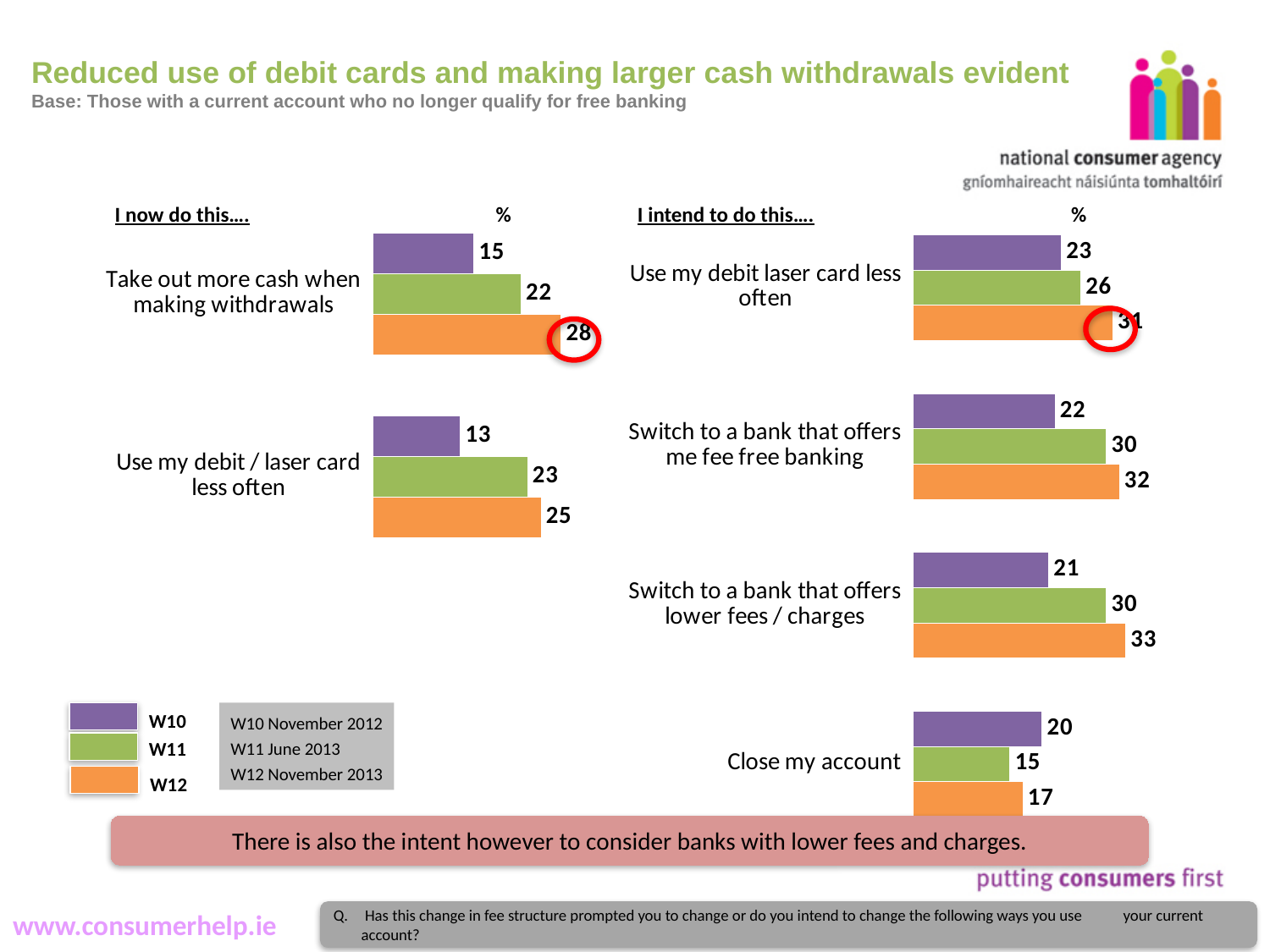
In the 'I now do this….' chart, what is the difference between the W12 and W10 values for 'Take out more cash when making withdrawals'? 13 In the 'I intend to do this….' chart, which is larger for 'Close my account': the W10 value or the W12 value? W10 How many series does the legend list? 3 How many categories are shown in the 'I intend to do this….' chart? 4 In the 'I now do this….' chart, what is the W10 value for 'Use my debit / laser card less often'? 13 In the 'I now do this….' chart, what is the W12 value for 'Take out more cash when making withdrawals'? 28 In the 'I intend to do this….' chart, which category has the lowest W11 value? Close my account In the 'I intend to do this….' chart, which category has the highest W12 value? Switch to a bank that offers lower fees / charges In the 'I intend to do this….' chart, what is the W11 value for 'Close my account'? 15 According to the legend, which survey wave does W11 correspond to? June 2013 In the 'I intend to do this….' chart, what is the W12 value for 'Switch to a bank that offers lower fees / charges'? 33 What kind of chart is used on this slide? Bar chart